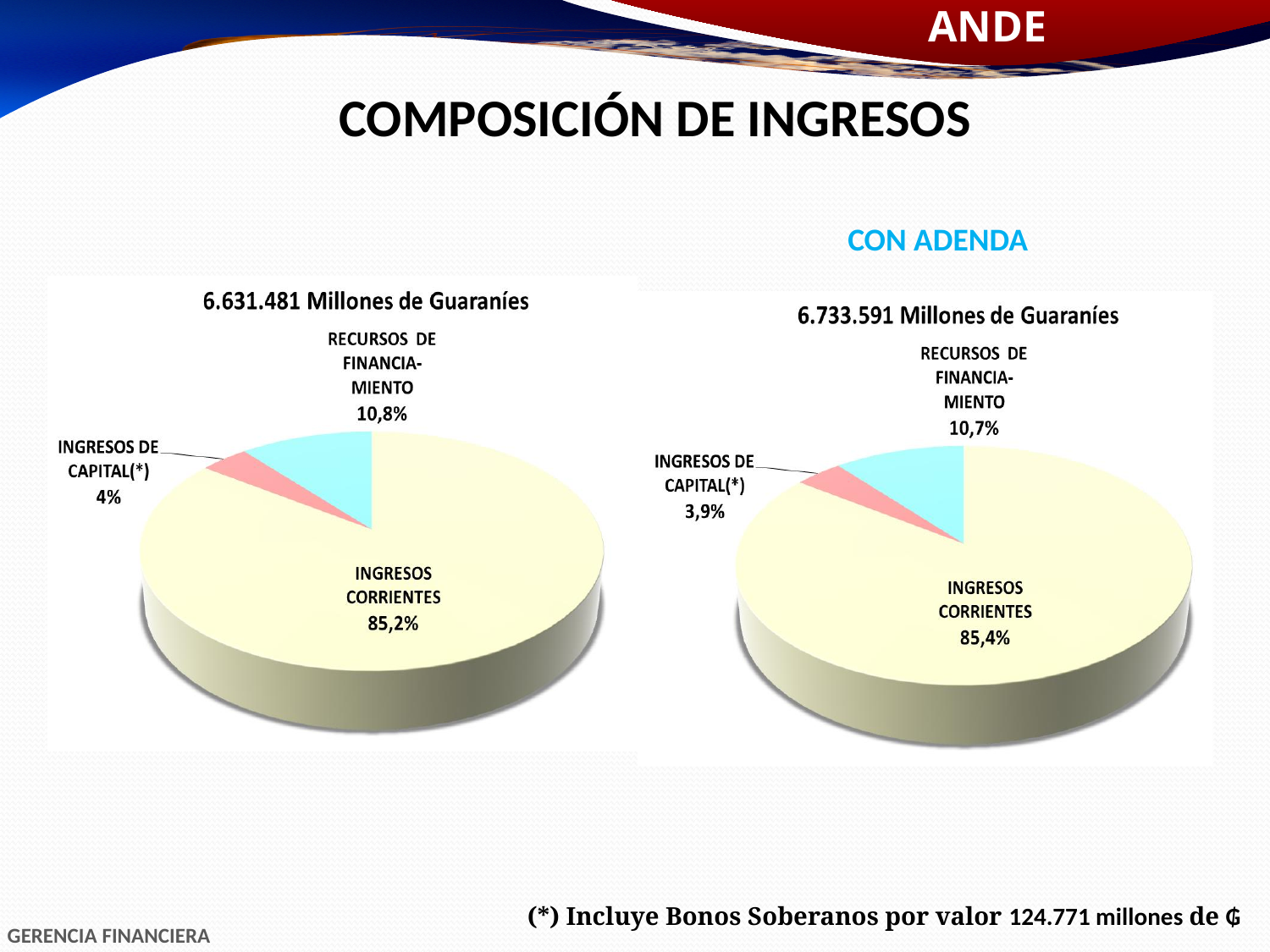
Which is larger: INGRESOS CORRIENTES in the left pie chart or INGRESOS CORRIENTES in the right pie chart? Right pie chart (85,4%) In the right pie chart, which category has the smallest share? INGRESOS DE CAPITAL(*) In the right pie chart, what share is INGRESOS DE CAPITAL(*)? 3,9% In the left pie chart, what is the difference between the shares of RECURSOS DE FINANCIAMIENTO and INGRESOS DE CAPITAL(*)? 6,8% What is the title of the right pie chart? 6.733.591 Millones de Guaraníes In the left pie chart, which category has the largest share? INGRESOS CORRIENTES In the right pie chart (6.733.591 Millones de Guaraníes, CON ADENDA), what share is RECURSOS DE FINANCIAMIENTO? 10,7% In the left pie chart (6.631.481 Millones de Guaraníes), what share is INGRESOS CORRIENTES? 85,2% How many slices does the left pie chart have? 3 What kind of chart is used on the right side of the slide? Pie chart What is the main title of the slide? COMPOSICIÓN DE INGRESOS In the left pie chart, what share is INGRESOS DE CAPITAL(*)? 4%